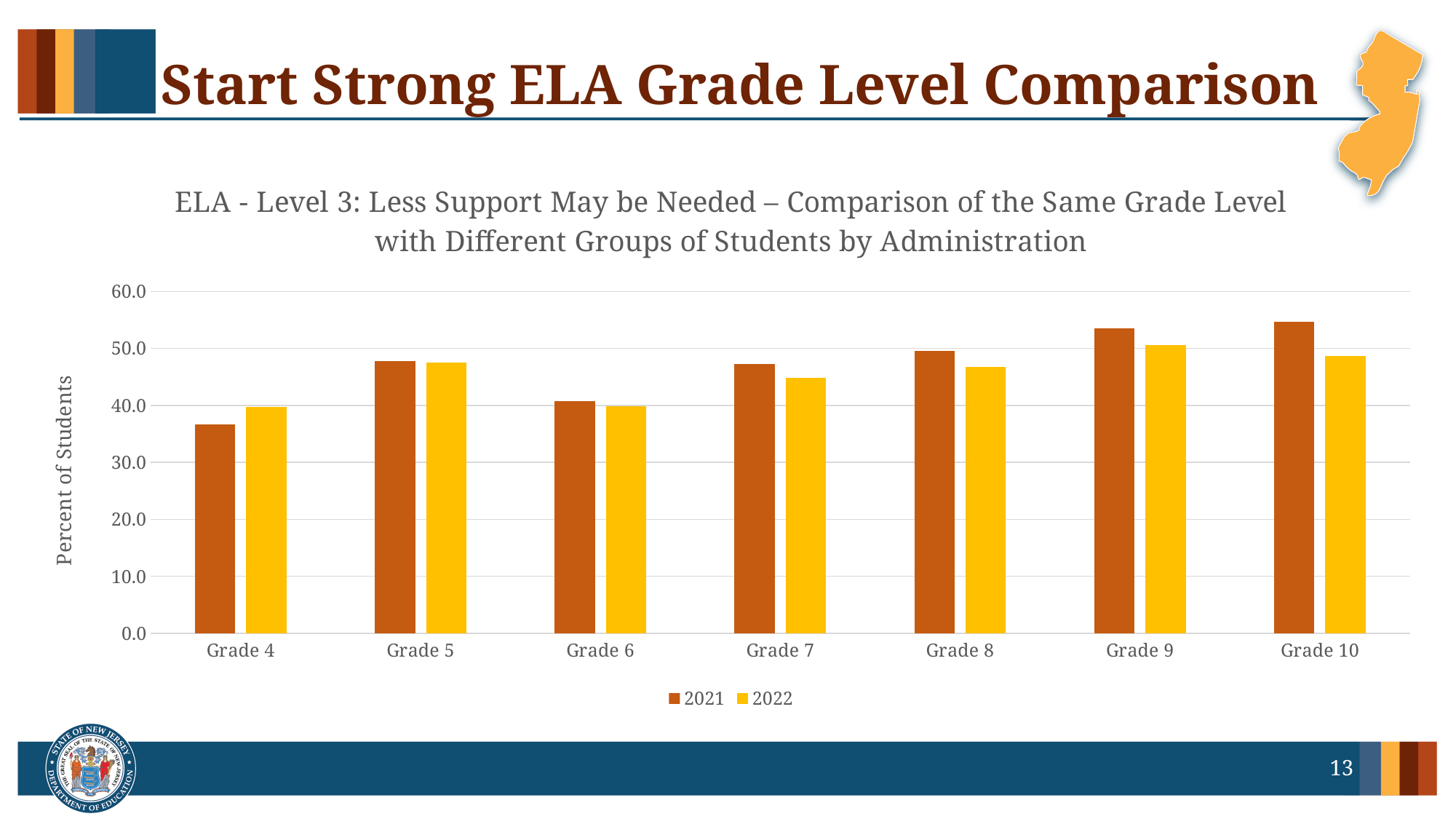
Is the 2021 value for Grade 10 greater or less than 50.0? greater Is the 2022 value for Grade 7 greater or less than 40.0? greater Is the 2021 value for Grade 4 greater or less than 40.0? less Which grade has the highest value for 2022? Grade 9 What is the label on the vertical axis of the chart? Percent of Students How many grade levels are shown on the x axis of the chart? 7 For Grade 10, which series has the larger value, 2021 or 2022? 2021 Which grade has the lowest value for 2021? Grade 4 For Grade 4, which series has the larger value, 2021 or 2022? 2022 What kind of chart is shown on the slide? bar chart How many series does the chart's legend list? 2